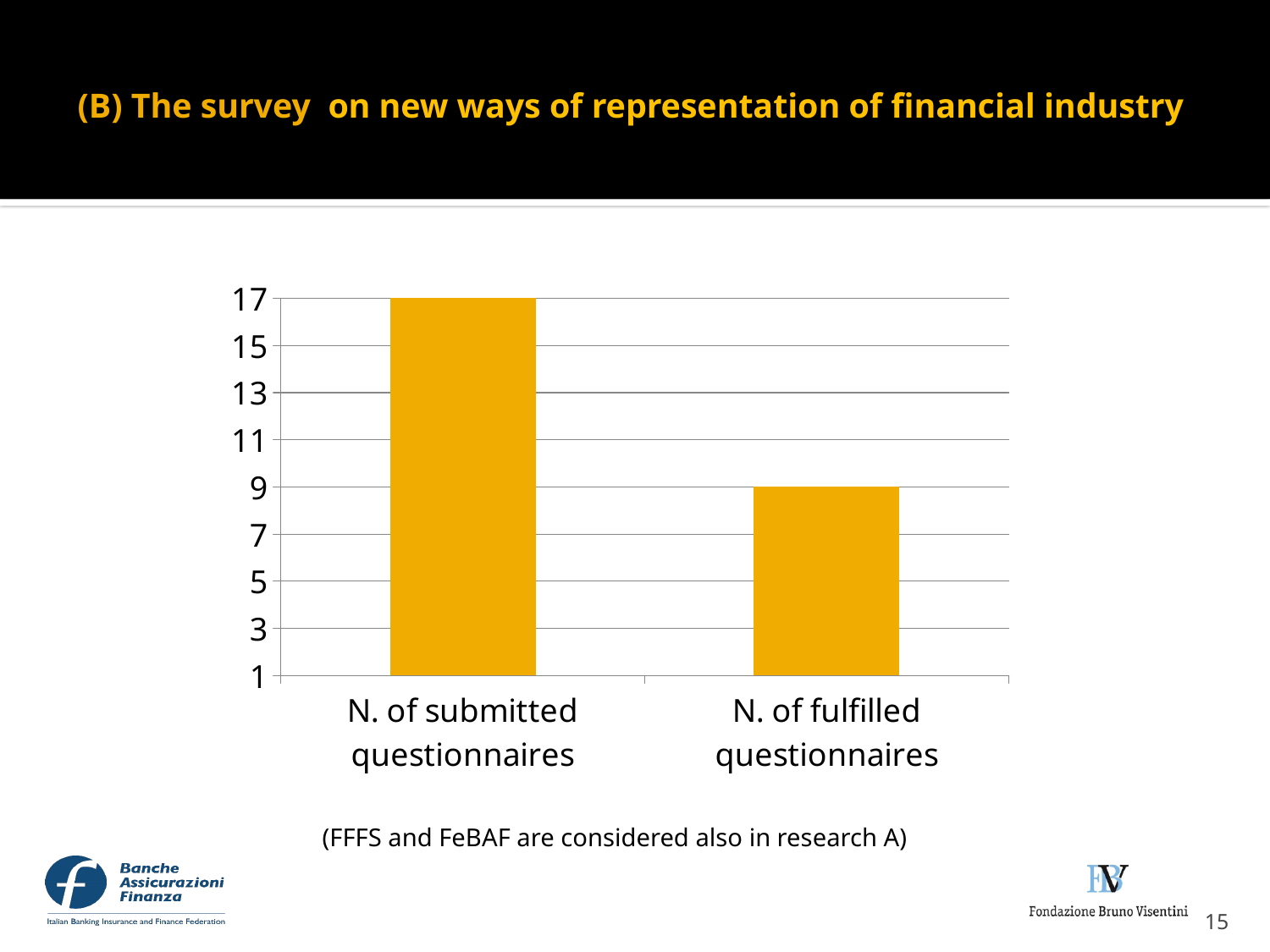
Is the value for N. of fulfilled questionnaires greater or less than 11? less What is the value for N. of submitted questionnaires? 17 Which category has the lowest value? N. of fulfilled questionnaires What colour are the bars in the chart? yellow/orange What kind of chart is shown on the slide? bar chart How many categories are plotted in the chart? 2 Is the value for N. of submitted questionnaires greater or less than 15? greater Do the values rise or fall from left to right along the x axis? fall Which is larger, N. of submitted questionnaires or N. of fulfilled questionnaires? N. of submitted questionnaires Which category has the highest value? N. of submitted questionnaires What is the value for N. of fulfilled questionnaires? 9 What is the difference between N. of submitted questionnaires and N. of fulfilled questionnaires? 8